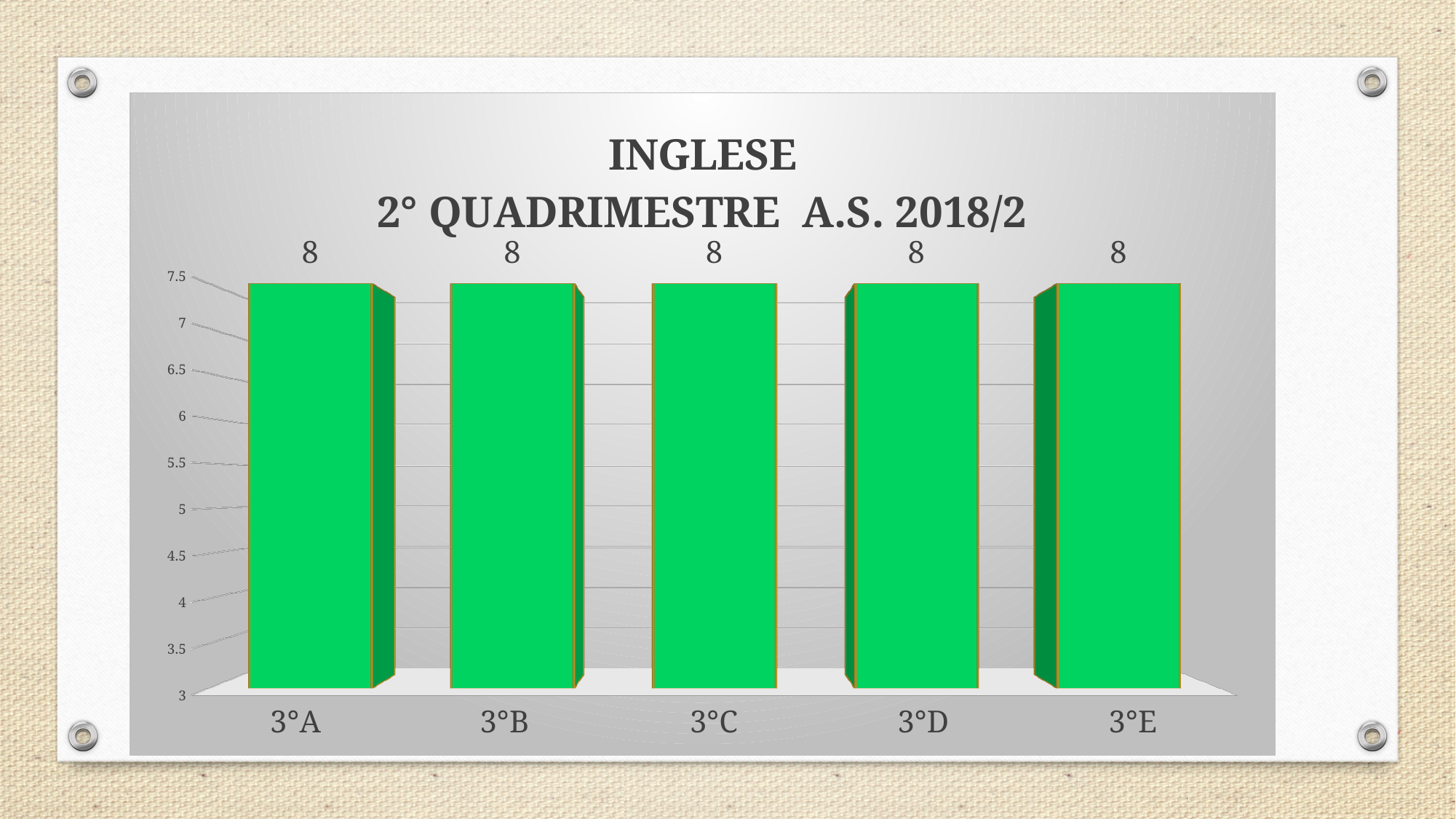
What is the difference between the values for 3°B and 3°D? 0 What is the value for 3°D? 8 What kind of chart is shown on the slide? bar chart Which subject is named in the chart title? INGLESE Do the values rise, fall or stay the same from 3°A to 3°E? stay the same What colour are the bars in the chart? green Is the value for 3°B greater or less than 7? greater What is the value for 3°C? 8 What is the value for 3°A? 8 What is the value for 3°E? 8 How many categories are shown on the x axis? 5